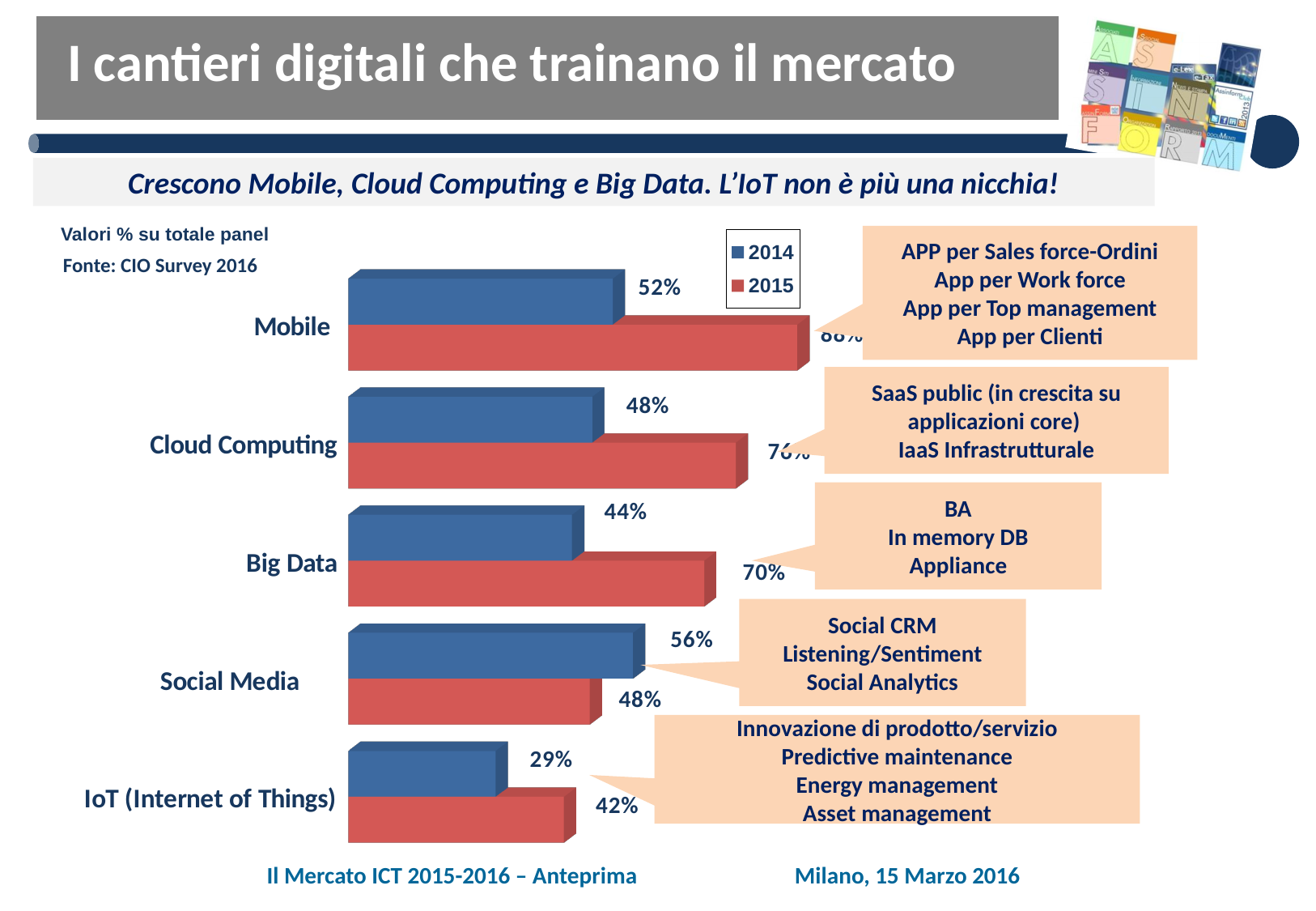
For Social Media, which is larger: the 2014 value or the 2015 value? 2014 Which colour represents the 2015 series in the chart? red What is the 2014 value for Mobile? 52% Which category has the highest 2014 value? Social Media What is the 2014 value for IoT (Internet of Things)? 29% How many series does the legend list? 2 What is the 2015 value for Social Media? 48% What kind of chart is shown on the slide? bar chart How many categories are plotted in the chart? 5 What is the 2015 value for Big Data? 70% What is the difference between the 2015 and 2014 values for Big Data? 26 percentage points Which category has the lowest 2015 value? IoT (Internet of Things)